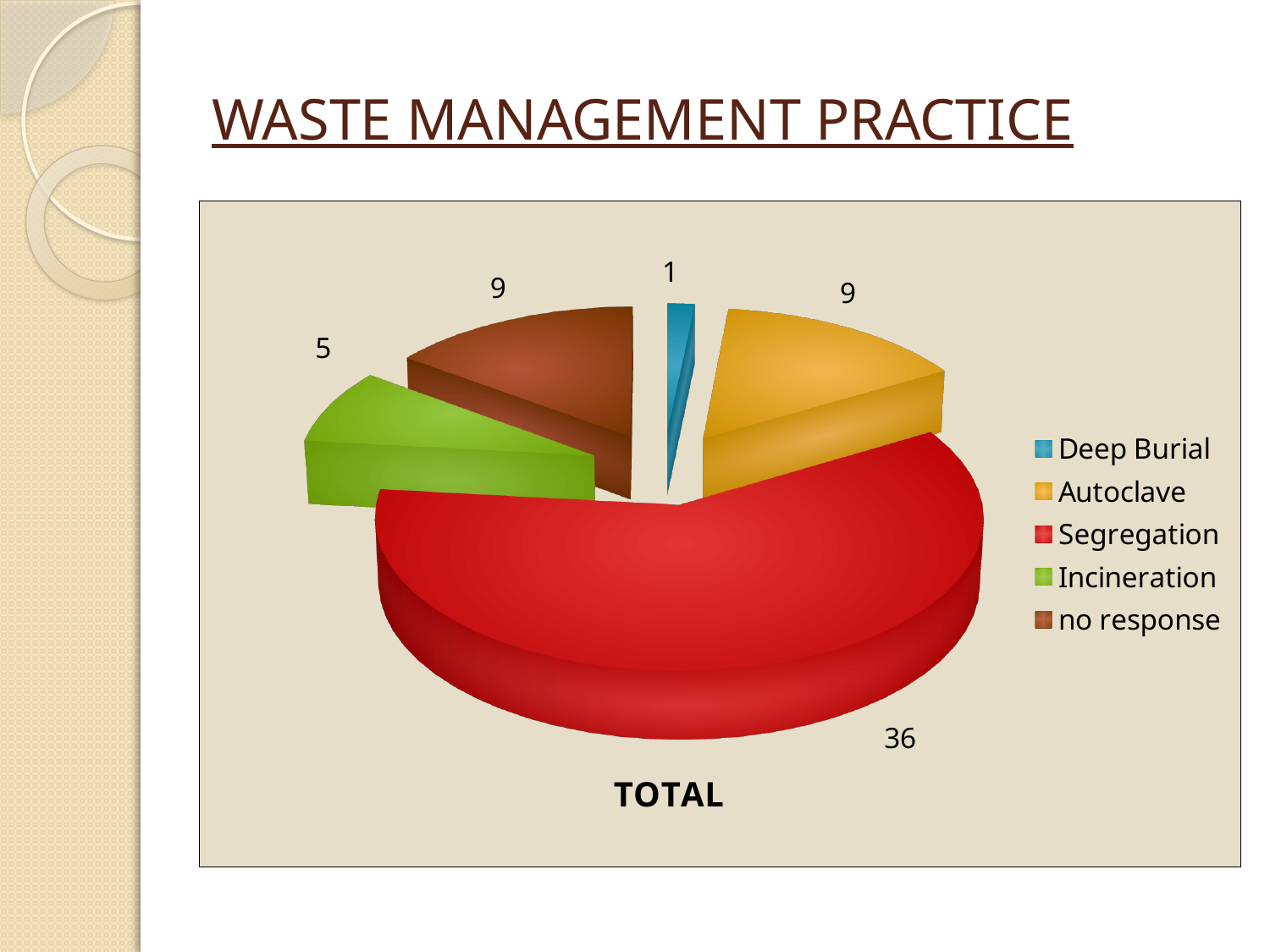
What share of the pie does Segregation represent? 60% What is the value for Incineration? 5 What is the value for Autoclave? 9 What is the difference between the values for Segregation and Autoclave? 27 What is the value for Segregation? 36 What is the title of the chart? TOTAL Which category has the smallest slice? Deep Burial Which is larger, the value for Incineration or the value for no response? no response What is the value for Deep Burial? 1 How many categories does the pie chart have? 5 Which category has the largest slice? Segregation What kind of chart is shown on the slide? Pie chart